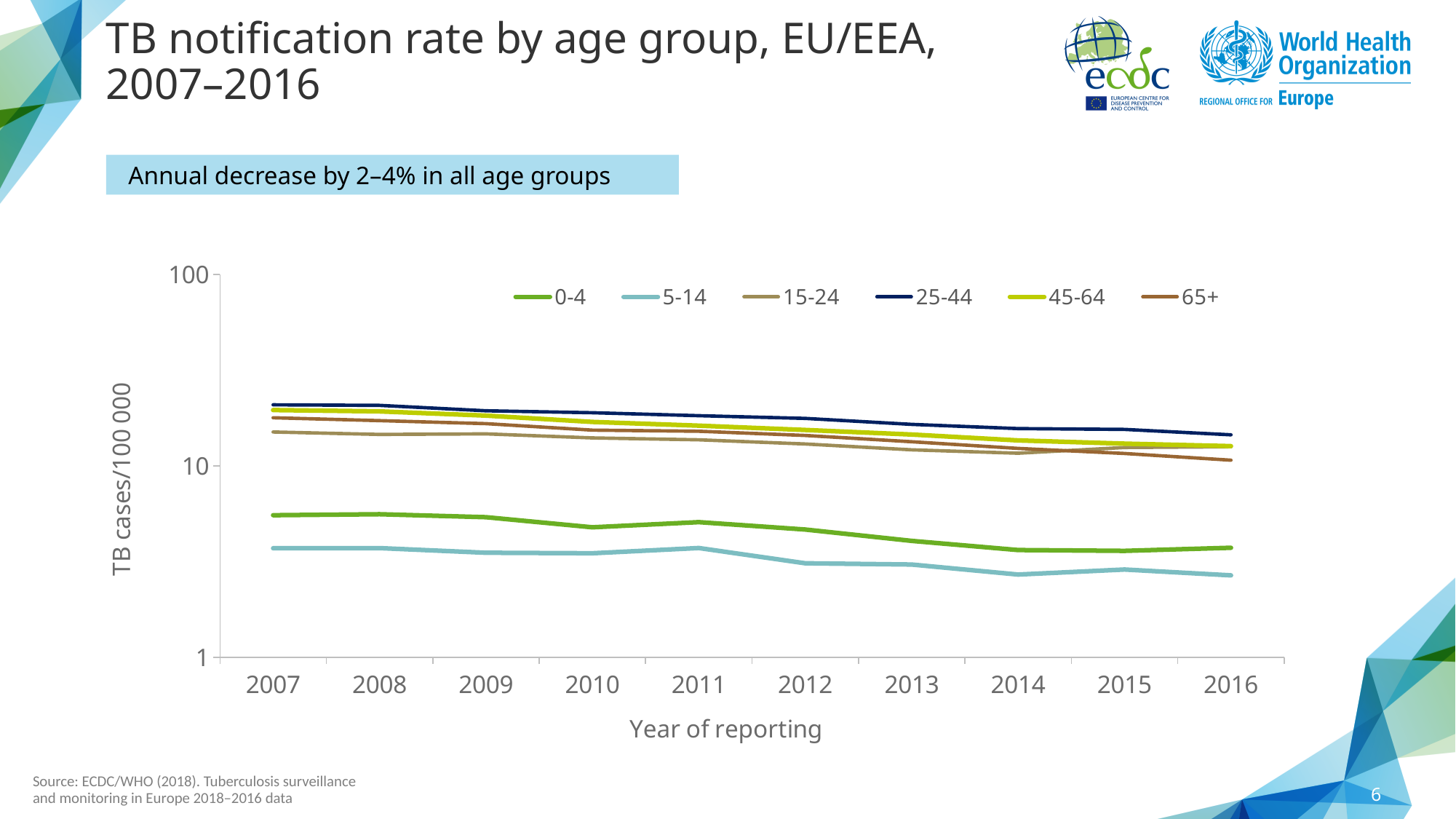
How many years of reporting are plotted along the x axis? 10 In 2010, which has the larger value: the 0-4 age group or the 5-14 age group? 0-4 How many age groups does the legend list? 6 What is the label of the y axis? TB cases/100 000 What kind of chart is shown on the slide? line chart Is the value for the 0-4 age group in 2007 greater or less than 10? less In 2012, which has the larger value: the 25-44 age group or the 15-24 age group? 25-44 Which age group has the highest TB notification rate in 2007? 25-44 Does the TB notification rate for the 25-44 age group rise or fall from 2007 to 2016? fall Is the value for the 5-14 age group in 2016 greater or less than 10? less Which age group has the lowest TB notification rate across the whole period? 5-14 Is the value for the 25-44 age group in 2007 greater or less than 10? greater